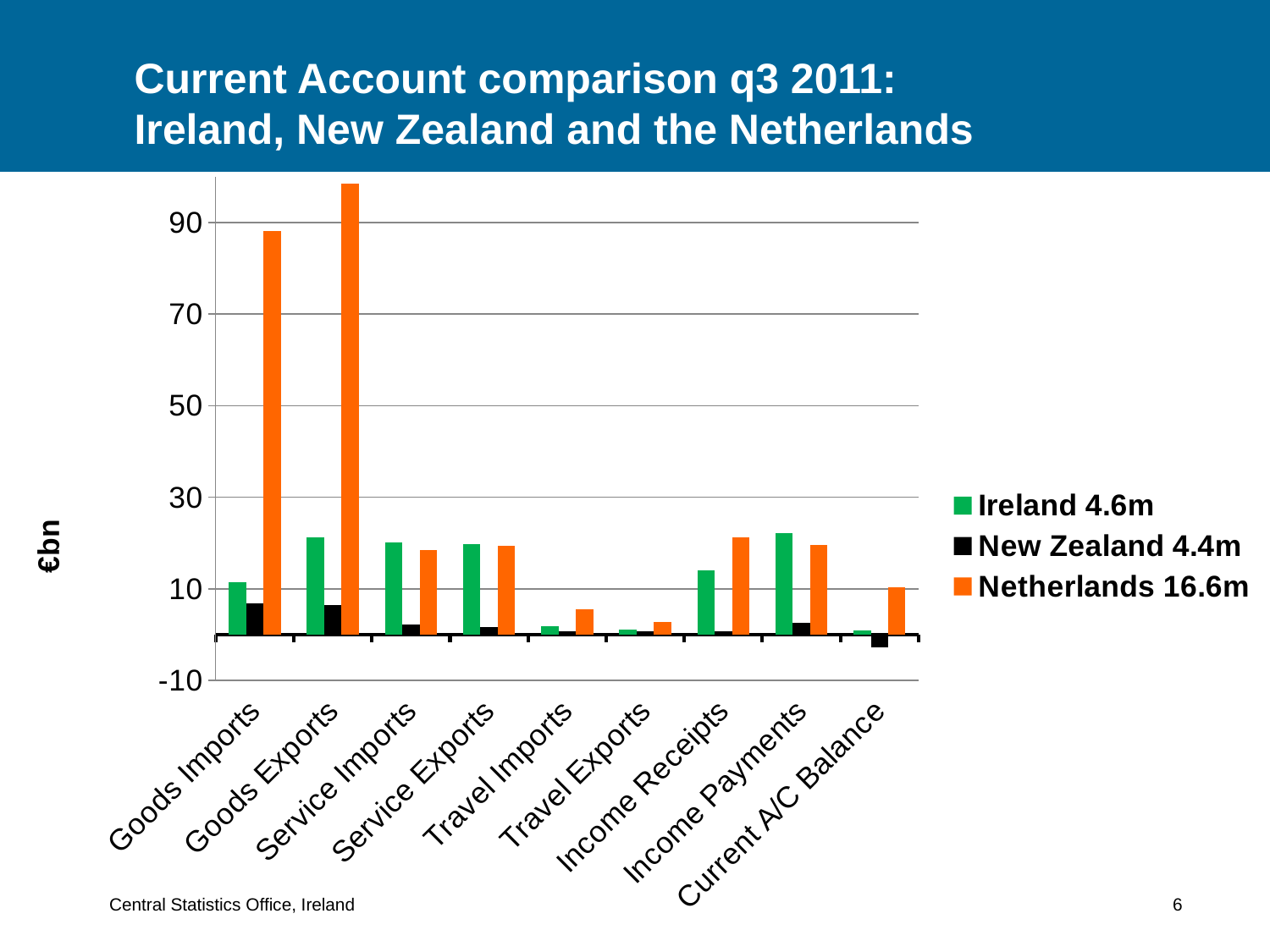
Is the value for Netherlands 16.6m in Travel Imports greater or less than 10? less Is the value for Netherlands 16.6m in Goods Imports greater or less than 70? greater What kind of chart is shown on the slide? bar chart Which category has the lowest value for New Zealand 4.4m? Current A/C Balance Which category has the highest value for Netherlands 16.6m? Goods Exports For Netherlands 16.6m, which is larger: Goods Imports or Goods Exports? Goods Exports How many categories are shown on the x axis? 9 Is the value for Ireland 4.6m in Income Payments greater or less than 10? greater What is the label on the vertical axis? €bn Which series has the highest value for Goods Imports? Netherlands 16.6m How many series does the legend list? 3